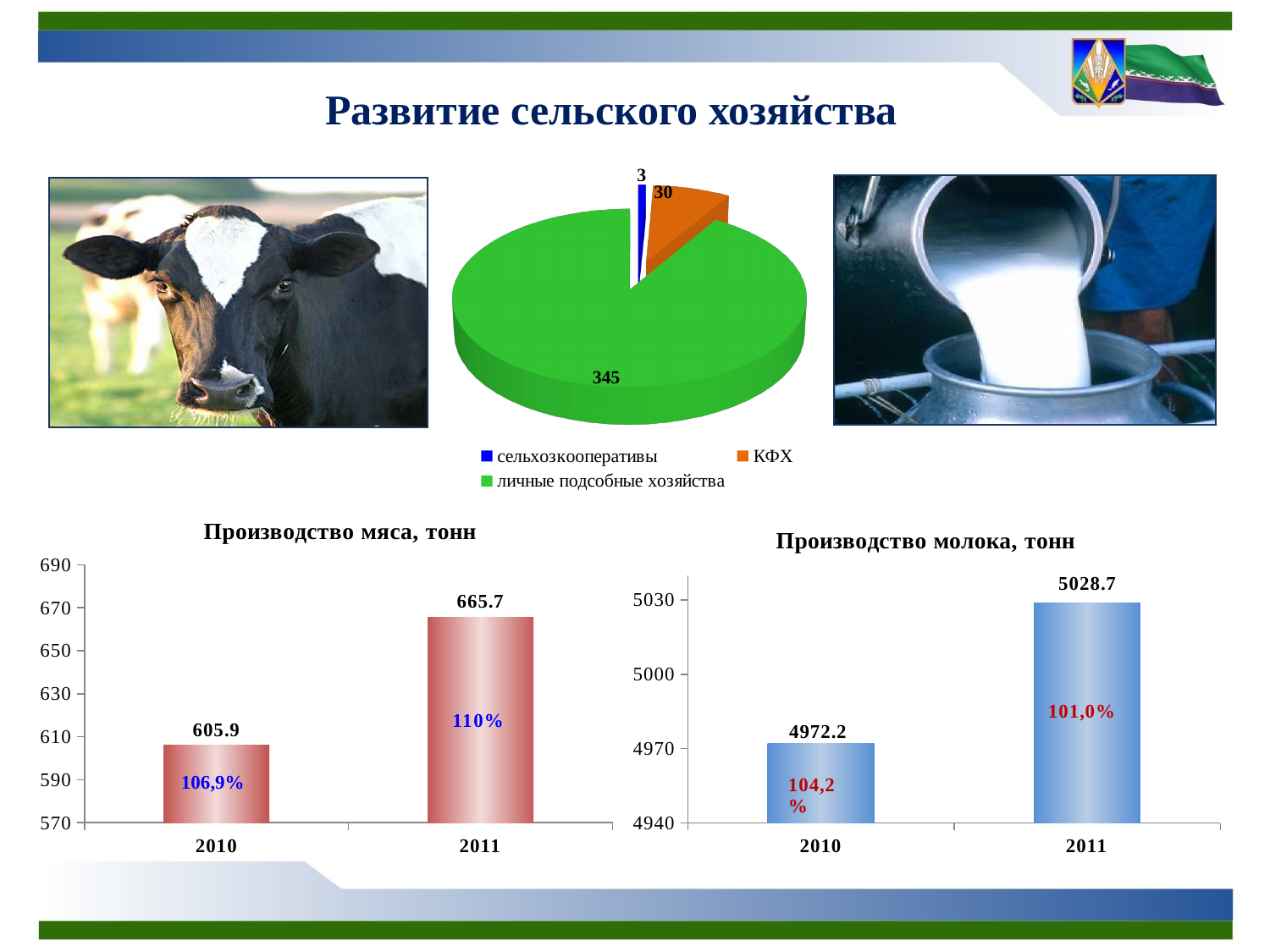
In the pie chart at the top of the slide, what is the difference between the values for КФХ and сельхозкооперативы? 27 In the pie chart at the top of the slide, what is the value for КФХ? 30 In the pie chart at the top of the slide, which category has the smallest value? сельхозкооперативы In the pie chart at the top of the slide, what is the value for личные подсобные хозяйства? 345 What kind of chart is 'Производство молока, тонн'? bar chart In the chart 'Производство мяса, тонн', what is the value for 2011? 665.7 In the chart 'Производство мяса, тонн', what is the value for 2010? 605.9 In the chart 'Производство мяса, тонн', by how much did the value increase from 2010 to 2011? 59.8 In the chart 'Производство молока, тонн', what percentage label is shown inside the 2011 bar? 101,0% In the chart 'Производство молока, тонн', which year has the higher value? 2011 In the chart 'Производство молока, тонн', what is the value for 2010? 4972.2 How many categories does the legend of the pie chart at the top of the slide list? 3